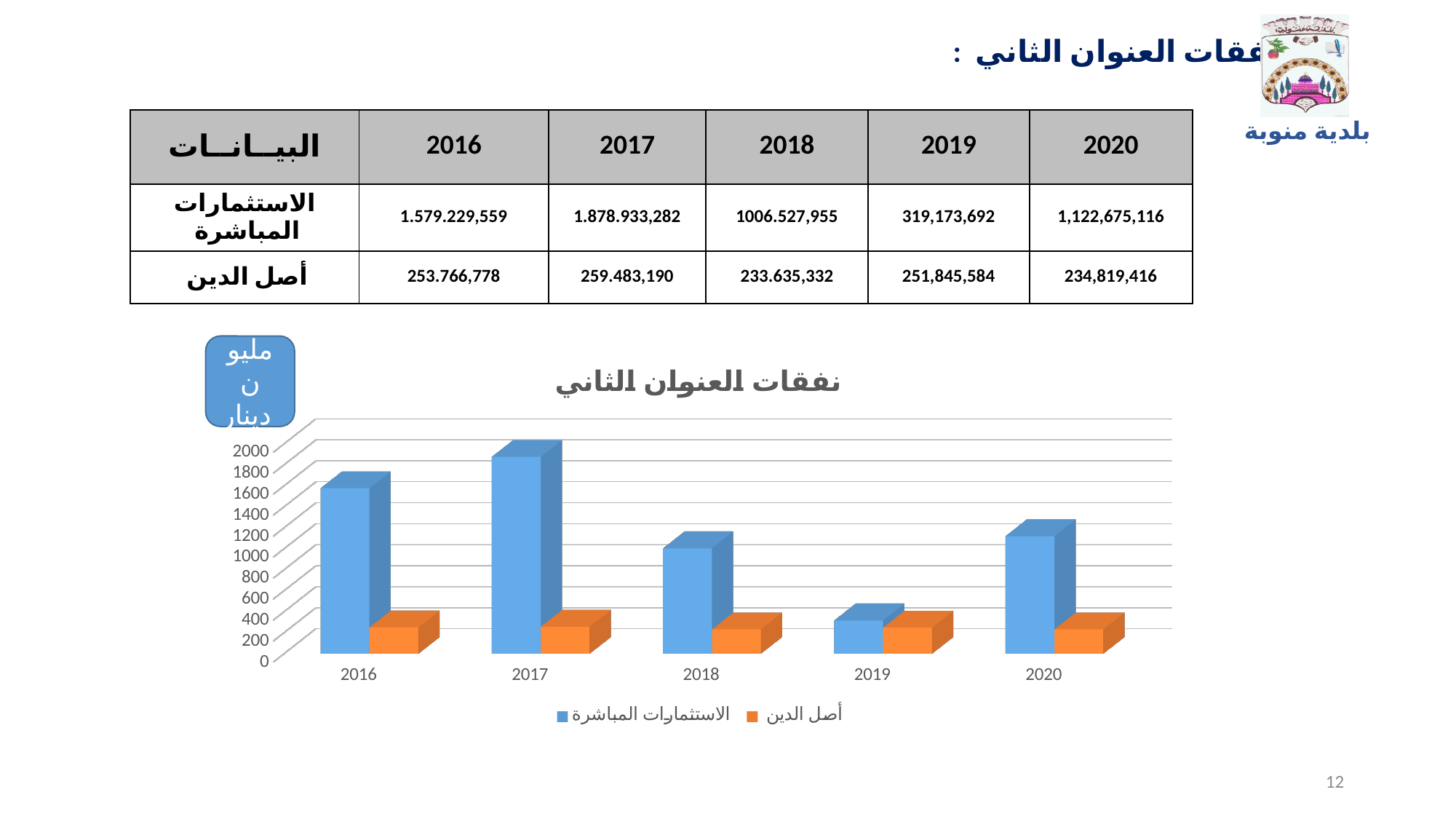
Is the value for الاستثمارات المباشرة in 2018 greater or less than 1200? less In 2017, which series has the larger value, الاستثمارات المباشرة or أصل الدين? الاستثمارات المباشرة Is the value for الاستثمارات المباشرة in 2016 greater or less than 1400? greater What kind of chart is shown on the slide? bar chart In which year is the value for الاستثمارات المباشرة highest in the chart? 2017 How many series does the chart legend list? 2 Is the value for أصل الدين in 2017 greater or less than 400? less What is the title of the chart? نفقات العنوان الثاني Between 2017 and 2019, do the values for الاستثمارات المباشرة rise or fall? fall In which year is the value for الاستثمارات المباشرة lowest in the chart? 2019 Which year has the larger value for الاستثمارات المباشرة, 2016 or 2020? 2016 How many years are shown on the x axis of the chart? 5